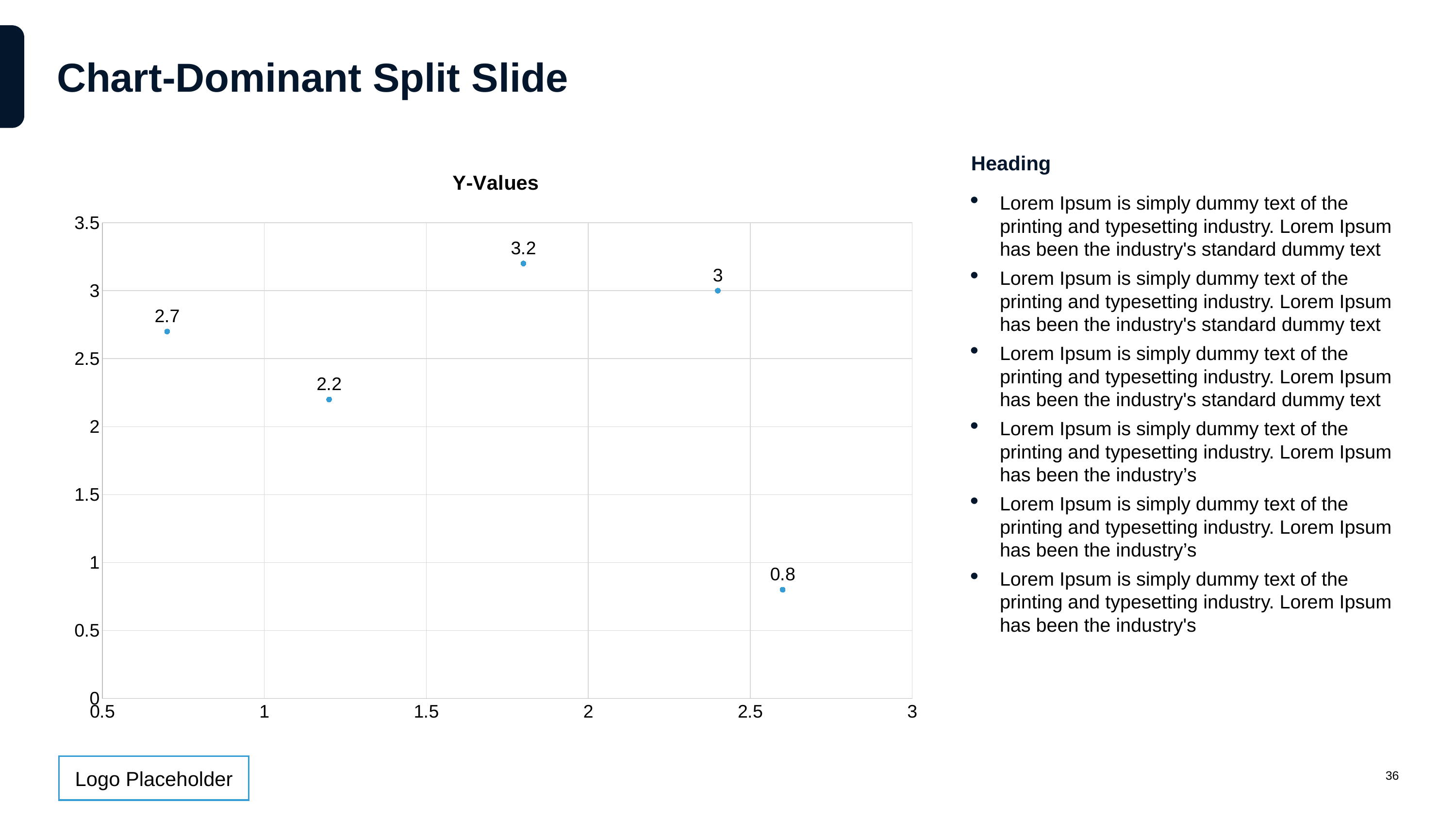
What is the highest y-value labelled in the chart? 3.2 What is the y-value of the leftmost point in the chart? 2.7 What is the y-value of the third point from the left in the chart? 3.2 What kind of chart is shown on the slide? scatter chart What is the difference between the y-values of the two leftmost points (2.7 and 2.2)? 0.5 What is the title of the chart? Y-Values What is the lowest y-value labelled in the chart? 0.8 What is the y-value of the rightmost point in the chart? 0.8 How many data points are plotted in the chart? 5 Is the y-value of the rightmost point greater or less than 1? less Which has the larger y-value: the point labelled 3 or the point labelled 3.2? 3.2 What is the difference between the highest and lowest labelled y-values in the chart? 2.4